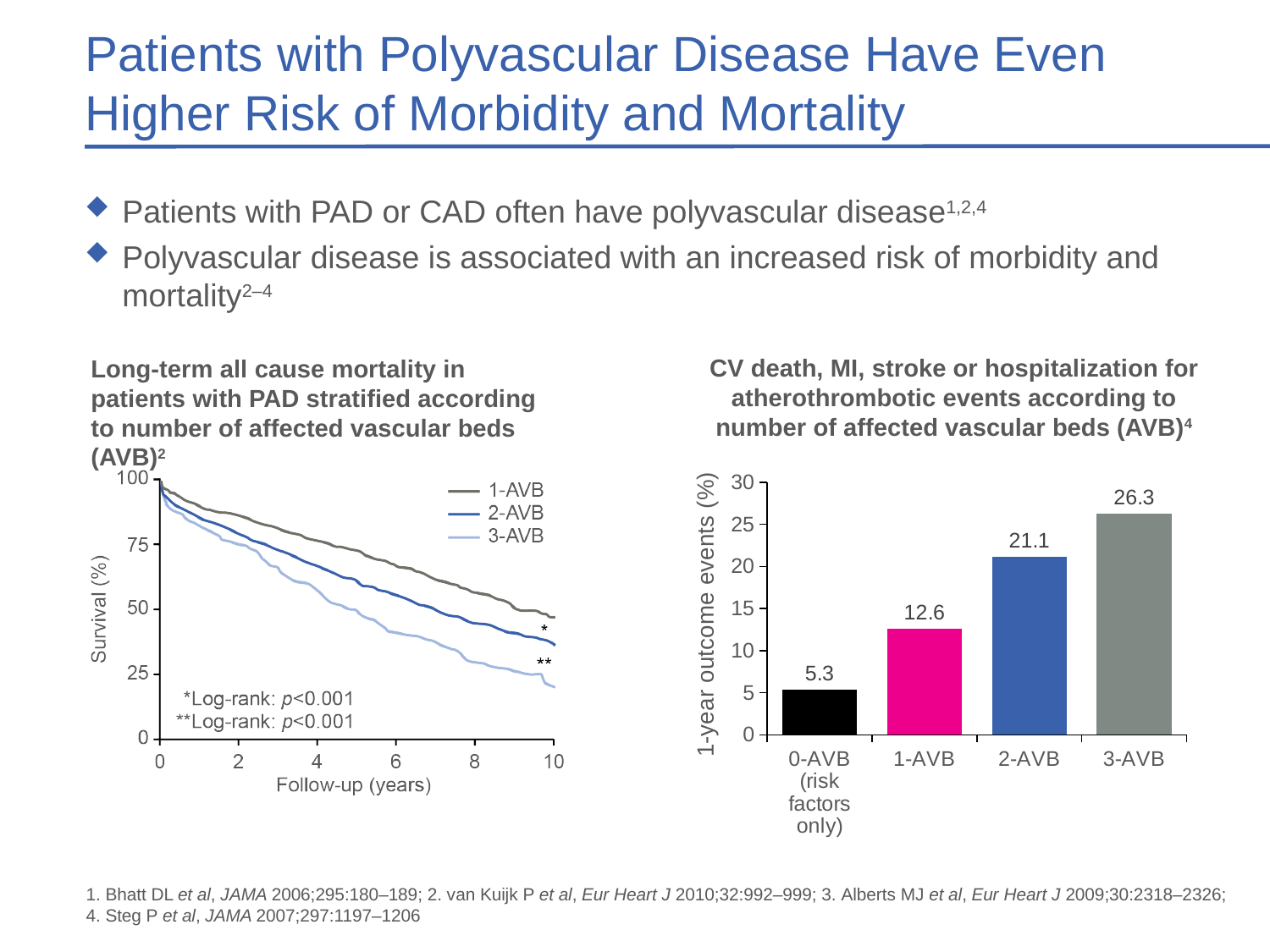
In the bar chart on the right, do the values rise or fall as the number of affected vascular beds increases? rise In the bar chart on the right, what is the difference between the values for 3-AVB and 1-AVB? 13.7 In the bar chart on the right, which category has the highest 1-year outcome event rate? 3-AVB In the left chart, is the survival for 3-AVB at 10 years of follow-up greater or less than 25%? less How many series does the legend of the left chart list? 3 In the bar chart on the right, how many categories are shown on the x axis? 4 In the bar chart on the right, what is the value for 2-AVB? 21.1 What kind of chart is the chart on the left showing survival over follow-up years? line chart In the bar chart on the right, which category has the lowest value? 0-AVB (risk factors only) In the bar chart on the right, what is the 1-year outcome event rate for 3-AVB? 26.3 In the bar chart on the right, which is larger, the value for 2-AVB or the value for 1-AVB? 2-AVB In the bar chart on the right, what is the value for 0-AVB (risk factors only)? 5.3